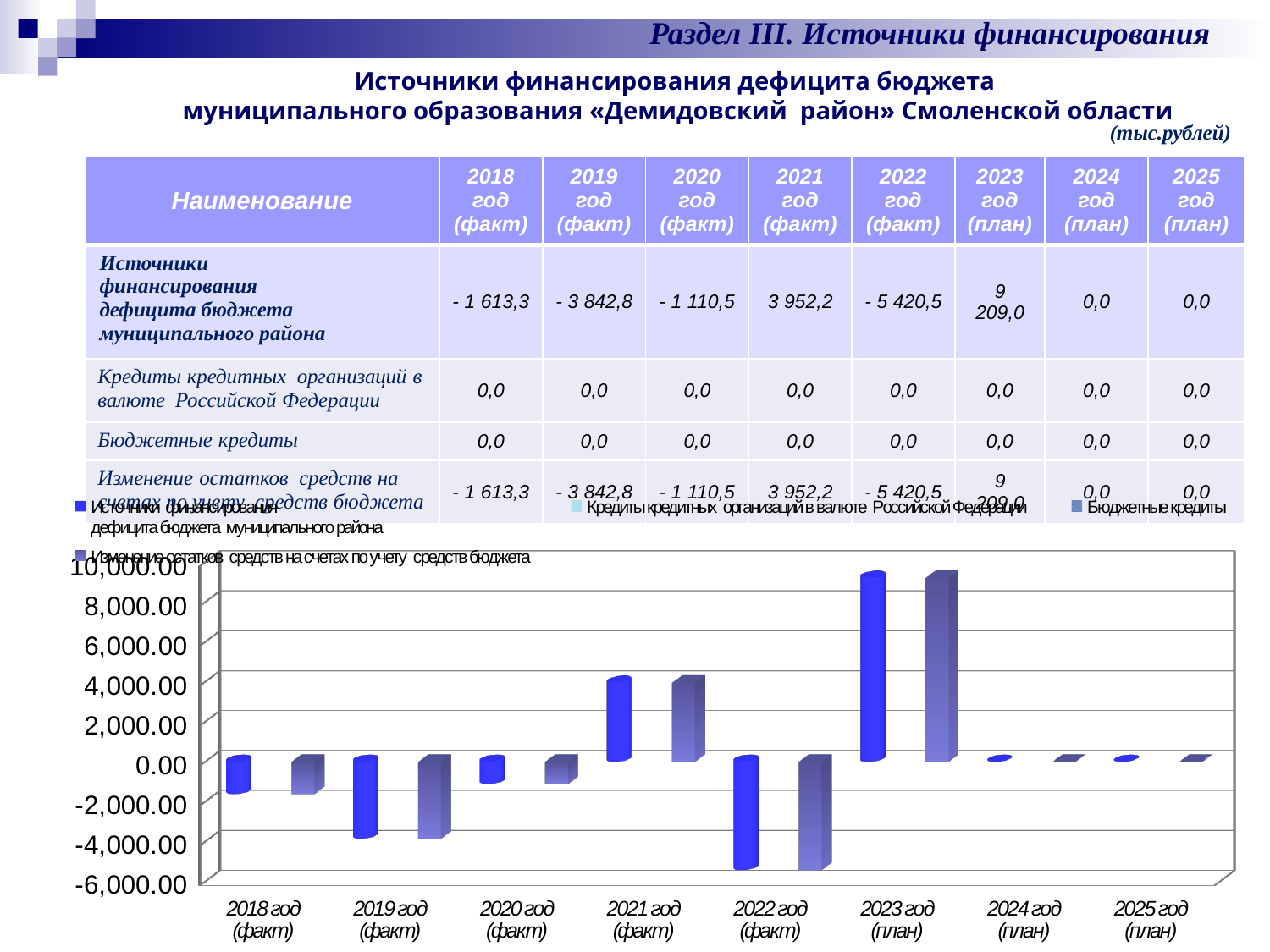
Which is larger, the value for 2019 год (факт) or the value for 2020 год (факт)? 2020 год (факт) What kind of chart is shown on the slide? bar chart Which year has the lowest value in the chart? 2022 год (факт) Is the value for 2023 год (план) greater or less than 8,000.00? greater Which year has the highest value in the chart? 2023 год (план) How many series does the chart legend list? 4 How many year categories are shown along the x axis of the chart? 8 According to the table, what is the value of 'Источники финансирования дефицита бюджета муниципального района' for 2022 год (факт)? - 5 420,5 Is the value for 2022 год (факт) greater or less than -4,000.00? less What unit is stated for the values on the slide? тыс.рублей According to the table, what is the value of 'Источники финансирования дефицита бюджета муниципального района' for 2021 год (факт)? 3 952,2 Is the value for 2021 год (факт) greater or less than 2,000.00? greater